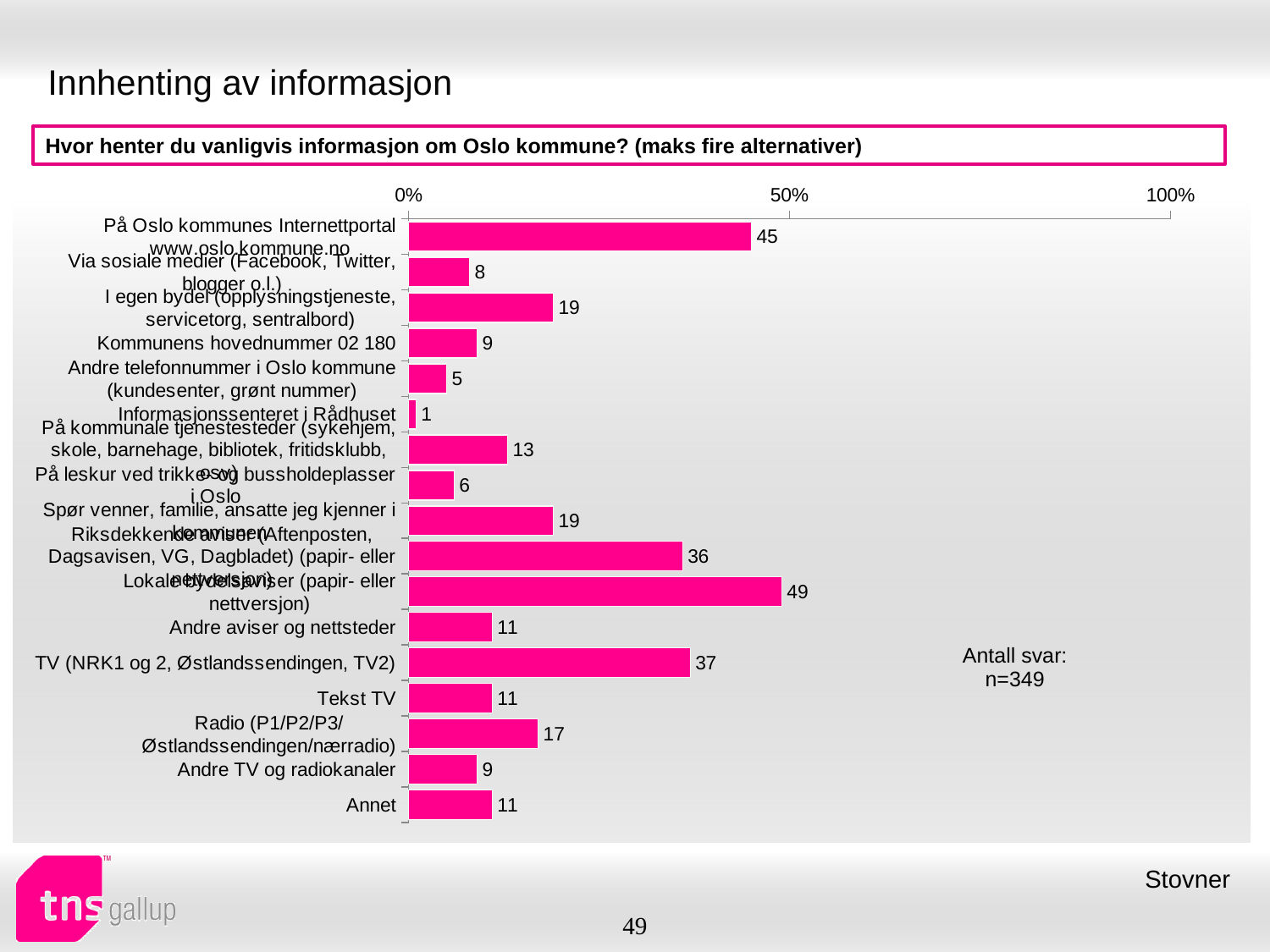
Which is larger: the value for "Riksdekkende aviser" or the value for "TV (NRK1 og 2, Østlandssendingen, TV2)"? TV (NRK1 og 2, Østlandssendingen, TV2) What kind of chart is shown on the slide? Bar chart What is the difference between the values for "Radio (P1/P2/P3/Østlandssendingen/nærradio)" and "Annet"? 6 How many categories are shown in the chart? 17 Which category has the lowest value? Informasjonssenteret i Rådhuset What is the number of respondents (n) stated on the slide? n=349 Is the value for "På Oslo kommunes Internettportal www.oslo.kommune.no" greater or less than 50%? less Which category has the highest value? Lokale bydelsaviser (papir- eller nettversjon) What value is shown for "Kommunens hovednummer 02 180"? 9 What value is shown for "Tekst TV"? 11 What value is shown for "TV (NRK1 og 2, Østlandssendingen, TV2)"? 37 What is the difference between the values for "Lokale bydelsaviser (papir- eller nettversjon)" and "På Oslo kommunes Internettportal www.oslo.kommune.no"? 4